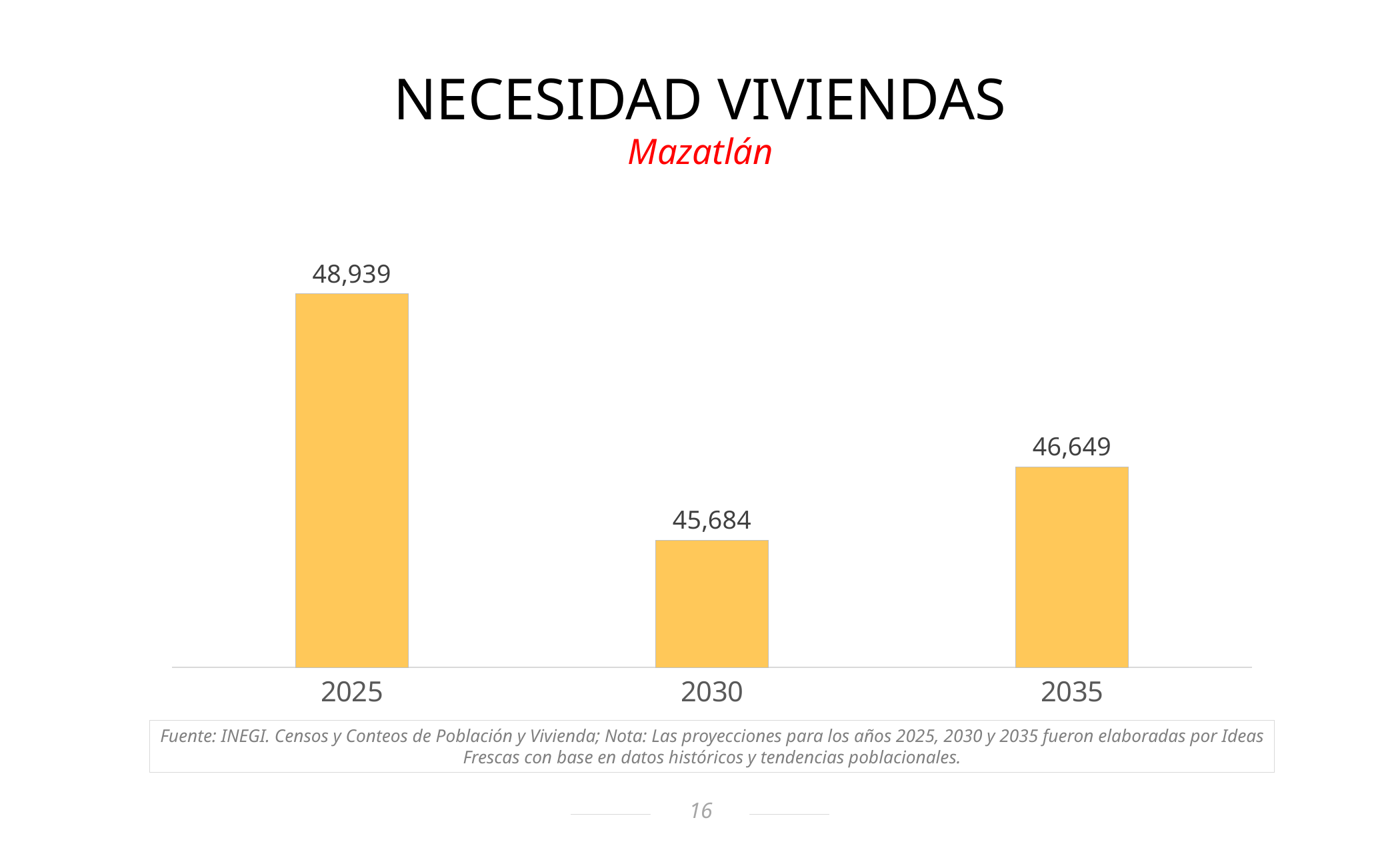
What is the value for 2030? 45,684 What is the title of the chart? NECESIDAD VIVIENDAS Mazatlán Does the value rise or fall from 2025 to 2030? fall What kind of chart is shown on the slide? bar chart What is the difference between the values for 2025 and 2030? 3,255 What is the value for 2035? 46,649 Which year has the lowest value? 2030 What is the value for 2025? 48,939 What is the difference between the values for 2035 and 2030? 965 Which year has the highest value? 2025 Which is larger, the value for 2030 or the value for 2035? 2035 How many years are shown on the x axis? 3